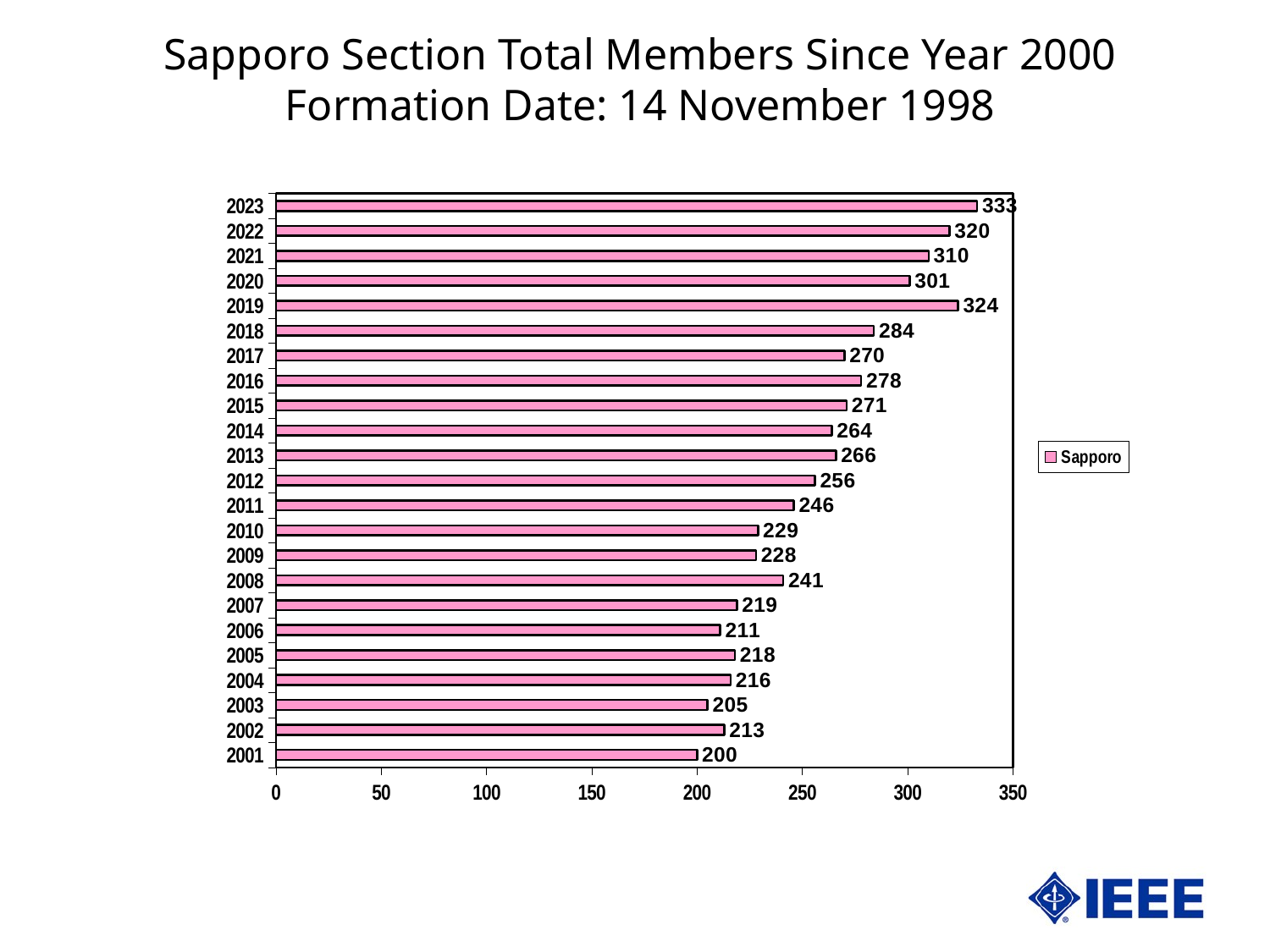
How many series does the legend list? 1 Which year has the lowest value? 2001 Is the value for 2018 greater or less than 250? greater What is the difference between the values for 2023 and 2022? 13 Which is larger, the value for 2019 or the value for 2020? 2019 What is the value for 2019? 324 What is the value for 2012? 256 What is the value for 2001? 200 How many years are shown on the chart? 23 Which year has the highest value? 2023 What kind of chart is shown? bar chart What series name is shown in the legend? Sapporo